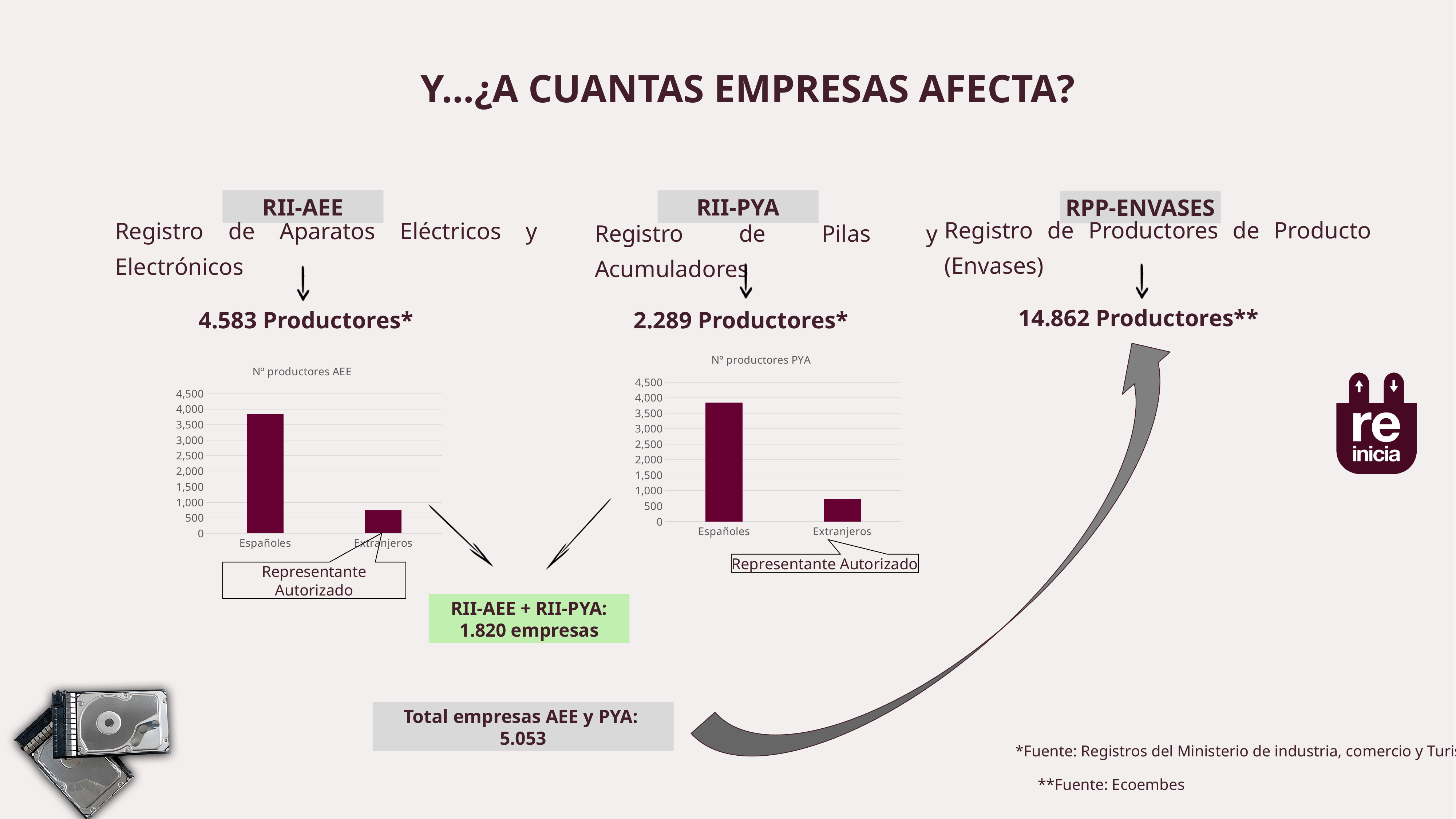
In the chart titled "Nº productores PYA", which is larger, the value for Españoles or the value for Extranjeros? Españoles In the chart titled "Nº productores PYA", which category has the highest value? Españoles In the chart titled "Nº productores PYA", is the value for Españoles greater or less than 3,500? greater In the chart titled "Nº productores AEE", which category has the highest value? Españoles In the chart titled "Nº productores AEE", what kind of chart is shown? bar chart In the chart titled "Nº productores AEE", which category has the lowest value? Extranjeros In the chart titled "Nº productores AEE", is the value for Extranjeros greater or less than 1,000? less What is the title of the chart on the left side of the slide? Nº productores AEE In the chart titled "Nº productores AEE", is the value for Españoles greater or less than 3,500? greater In the chart titled "Nº productores AEE", how many categories are shown on the x axis? 2 In the chart titled "Nº productores PYA", what kind of chart is shown? bar chart